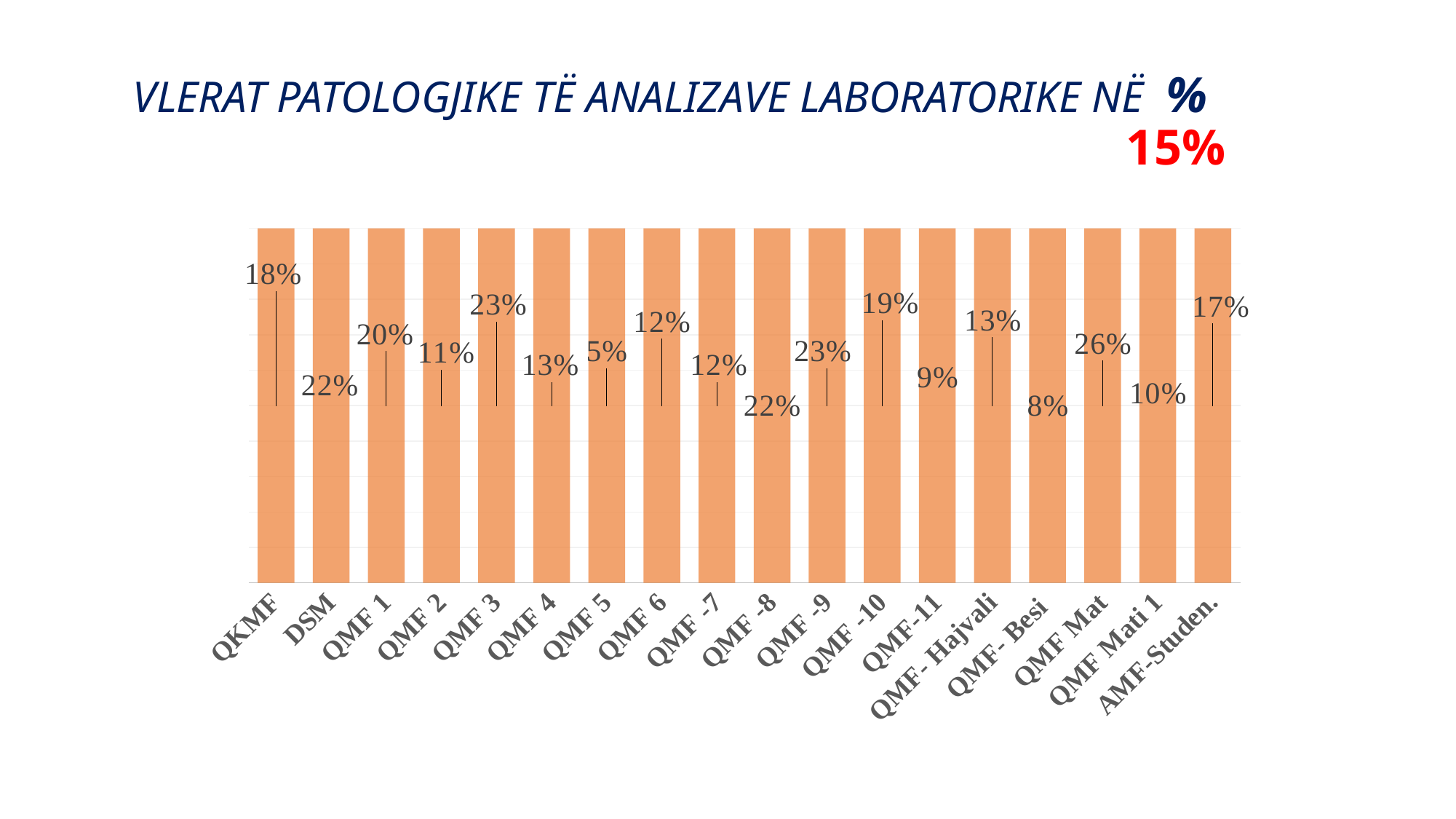
Which has the larger labelled value, QMF 3 or QMF 4? QMF 3 What kind of chart is shown on the slide? Bar chart Which category has the highest labelled value? QMF Mat How many categories are shown on the x axis? 18 What is the value shown for QMF Mat? 26% What value is highlighted in red next to the chart title? 15% What is the difference between the values for QMF Mat and QMF 5? 21% What is the value shown for QKMF? 18% What is the value shown for QMF- Besi? 8% What is the value shown for AMF-Studen.? 17% What is the difference between the values for DSM and QMF 2? 11% Which category has the lowest labelled value? QMF 5